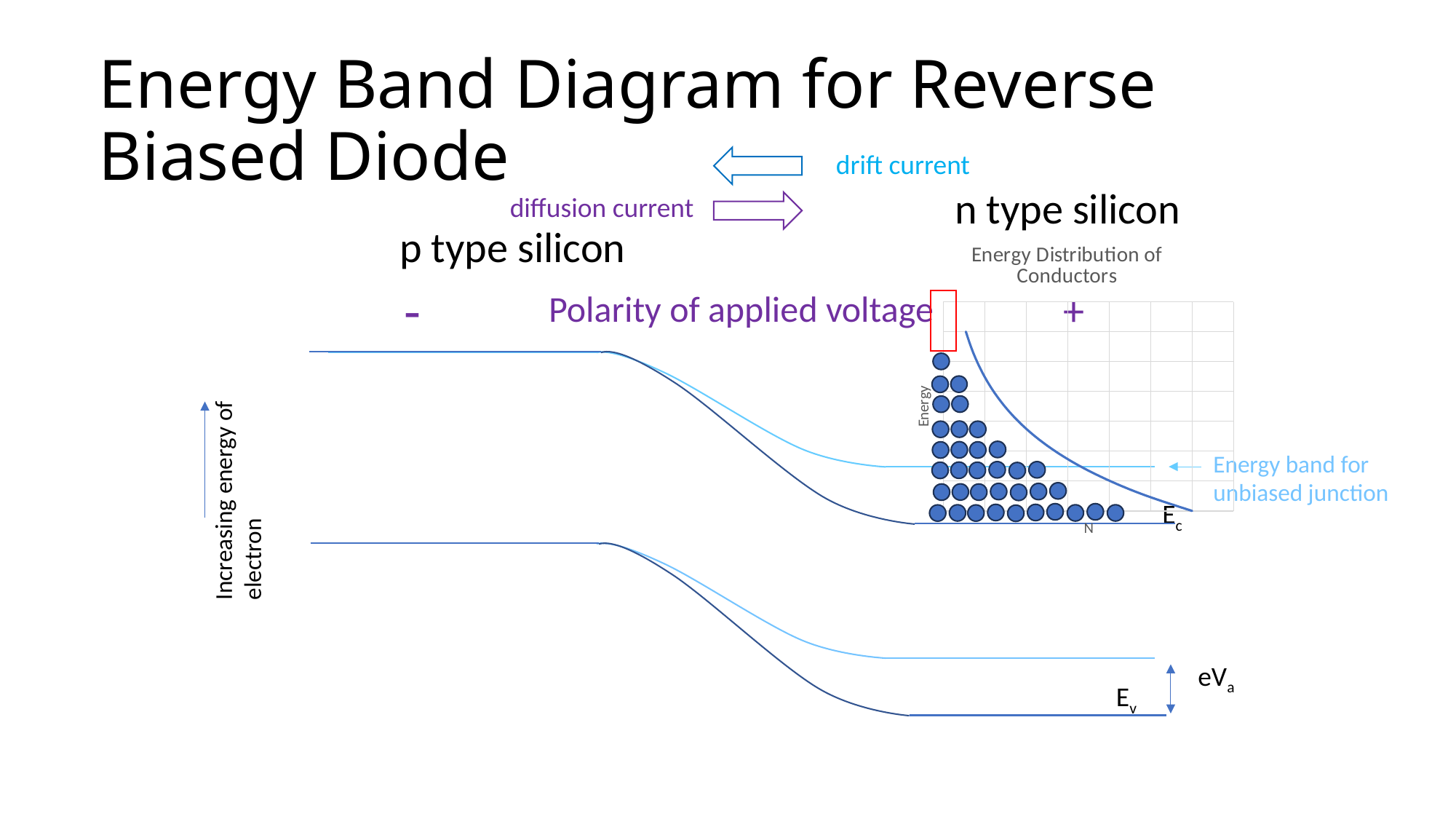
In the energy band diagram, which band is at higher energy, Ec or Ev? Ec What is the title of the small chart embedded on the right side of the slide? Energy Distribution of Conductors What kind of chart is the 'Energy Distribution of Conductors' chart? line chart What is the label on the vertical axis of the 'Energy Distribution of Conductors' chart? Energy In the energy band diagram, which side has the higher conduction band energy, the p type silicon side or the n type silicon side? p type silicon In the 'Energy Distribution of Conductors' chart, does the curve rise or fall as N increases along the x axis? fall